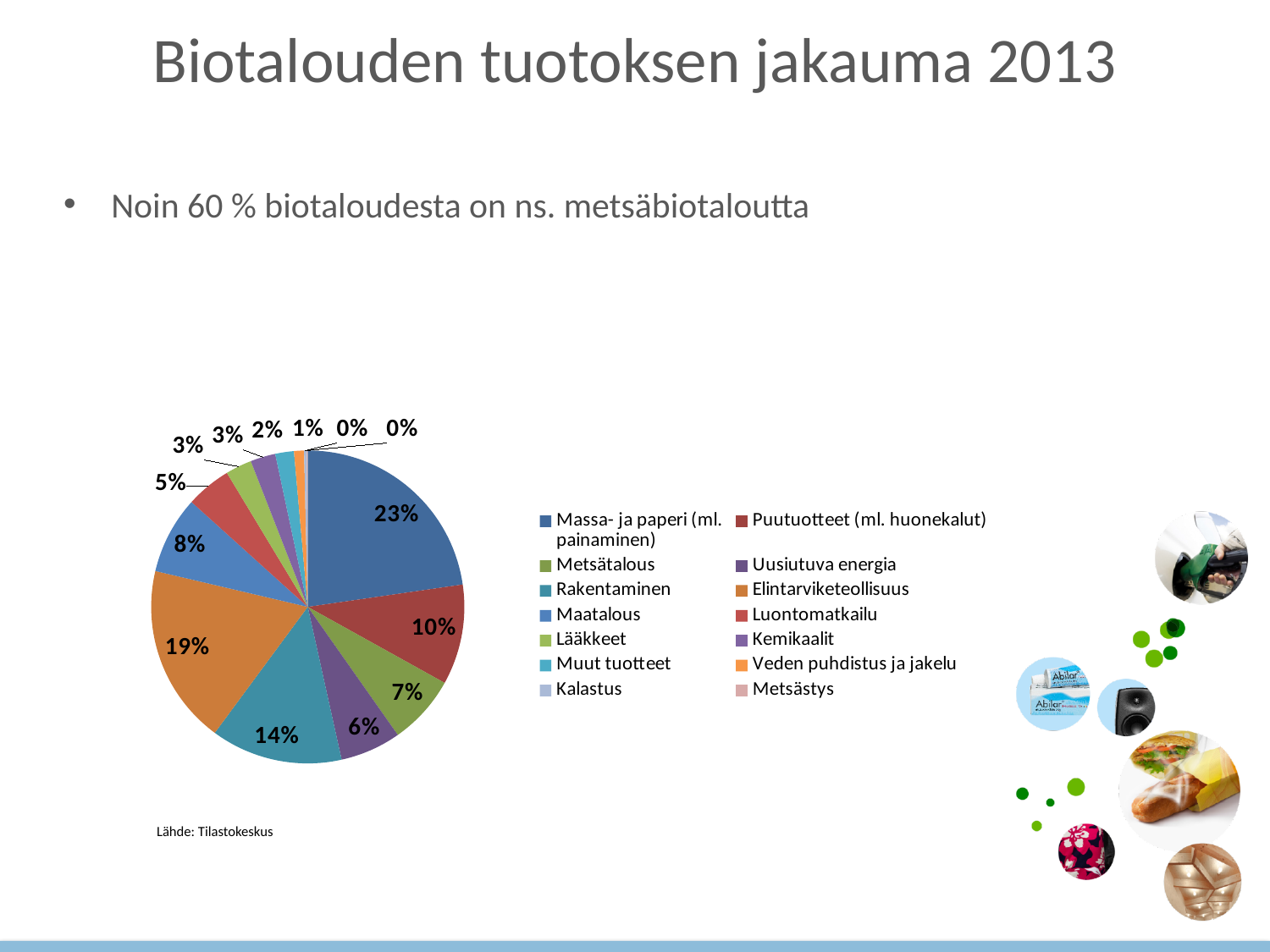
How many slices are labelled 0%? 2 What source is cited below the chart? Tilastokeskus What kind of chart is shown on the slide? Pie chart How many categories does the legend list? 14 What share of the pie does Massa- ja paperi (ml. painaminen) have? 23% How many percentage points larger is the Massa- ja paperi (ml. painaminen) slice than the Elintarviketeollisuus slice? 4 percentage points What percentage is shown for Rakentaminen? 14% Which category has the largest slice of the pie? Massa- ja paperi (ml. painaminen) What percentage is shown for Elintarviketeollisuus? 19% Which is larger, the slice for Puutuotteet (ml. huonekalut) or the slice for Maatalous? Puutuotteet (ml. huonekalut) What percentage is shown for Maatalous? 8% What percentage is shown for Luontomatkailu? 5%